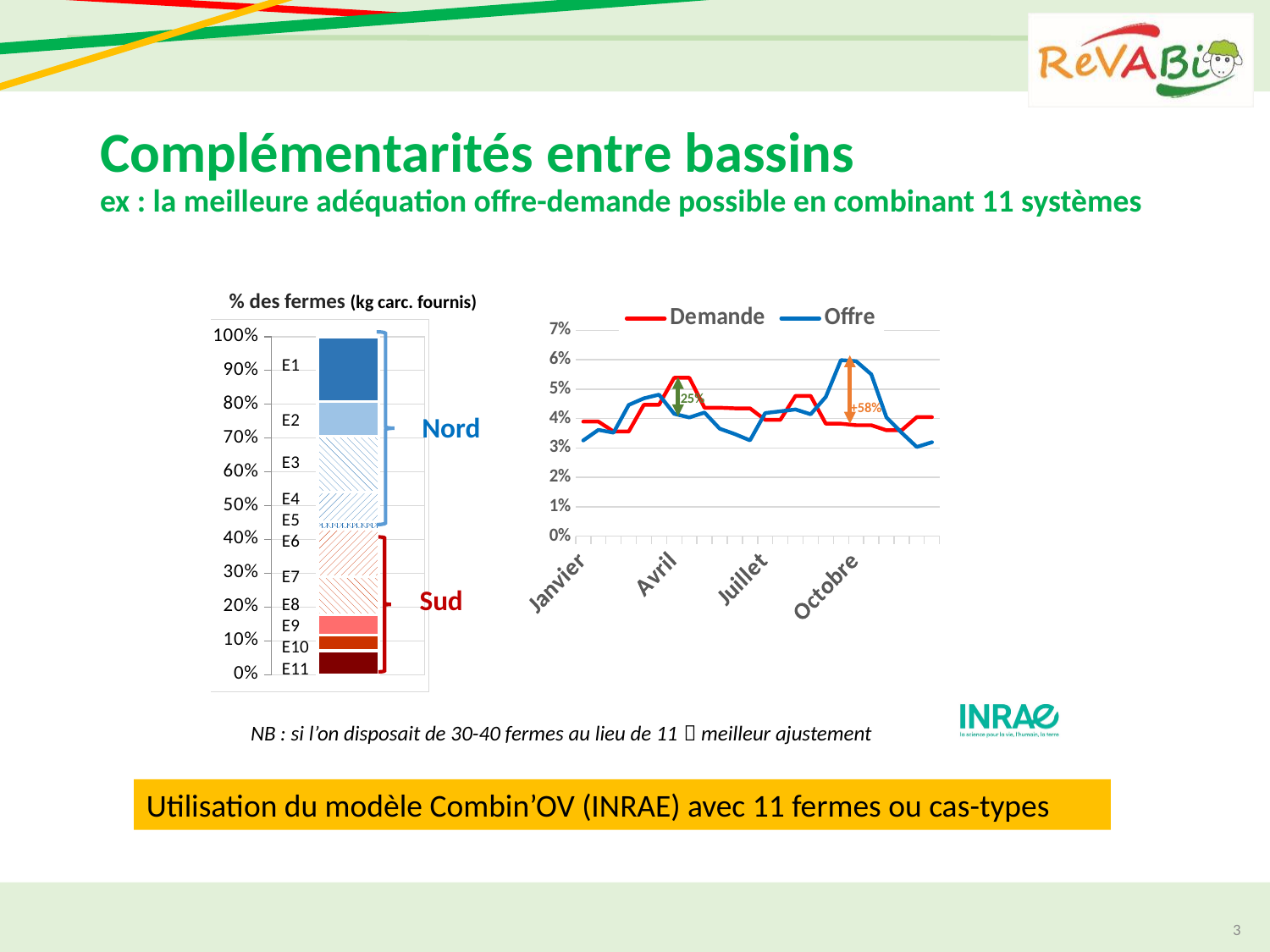
In the right chart, is the value of Offre in Janvier greater or less than 4%? less What kind of chart is the right chart with the Demande and Offre series? line chart In the left bar chart, which segment is the largest? E1 In the right chart, is the peak value of Demande around Avril greater or less than 5%? greater How many segments (E1 to E11) are stacked in the left bar chart? 11 What kind of chart is the left chart titled '% des fermes (kg carc. fournis)'? bar chart In the left bar chart, which group accounts for a larger share of the bar, Nord or Sud? Nord In the right chart, is the peak value of Offre around Octobre greater or less than 5%? greater How many series does the legend of the right chart list? 2 In the left bar chart, which segments are grouped under the label 'Sud'? E6 to E11 In the right chart, which series reaches the highest value over the year? Offre In the right chart, which series is drawn in blue? Offre